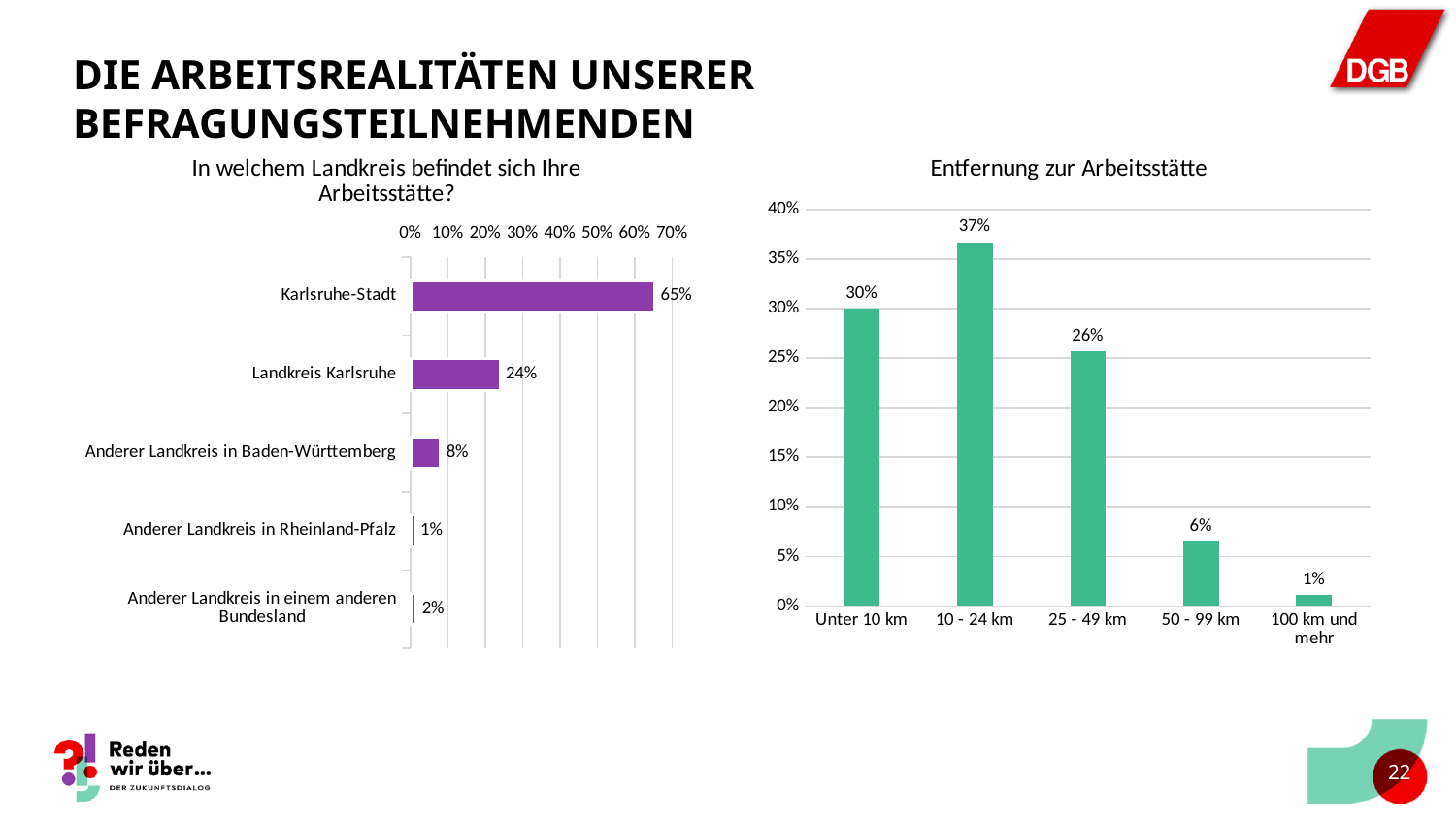
In the chart 'Entfernung zur Arbeitsstätte', what is the difference between 10 - 24 km and Unter 10 km? 7% In the chart 'In welchem Landkreis befindet sich Ihre Arbeitsstätte?', which category has the lowest value? Anderer Landkreis in Rheinland-Pfalz In the chart 'Entfernung zur Arbeitsstätte', what is the value for 25 - 49 km? 26% In the chart 'In welchem Landkreis befindet sich Ihre Arbeitsstätte?', what is the difference between Karlsruhe-Stadt and Landkreis Karlsruhe? 41% In the chart 'Entfernung zur Arbeitsstätte', which category has the highest value? 10 - 24 km In the chart 'In welchem Landkreis befindet sich Ihre Arbeitsstätte?', what is the value for Karlsruhe-Stadt? 65% In the chart 'Entfernung zur Arbeitsstätte', which is larger: Unter 10 km or 50 - 99 km? Unter 10 km What kind of chart is 'In welchem Landkreis befindet sich Ihre Arbeitsstätte?'? Bar chart In the chart 'Entfernung zur Arbeitsstätte', how many categories are shown on the x axis? 5 In the chart 'In welchem Landkreis befindet sich Ihre Arbeitsstätte?', what is the value for Landkreis Karlsruhe? 24% What colour are the bars in the chart 'Entfernung zur Arbeitsstätte'? Green In the chart 'In welchem Landkreis befindet sich Ihre Arbeitsstätte?', how many categories are shown? 5